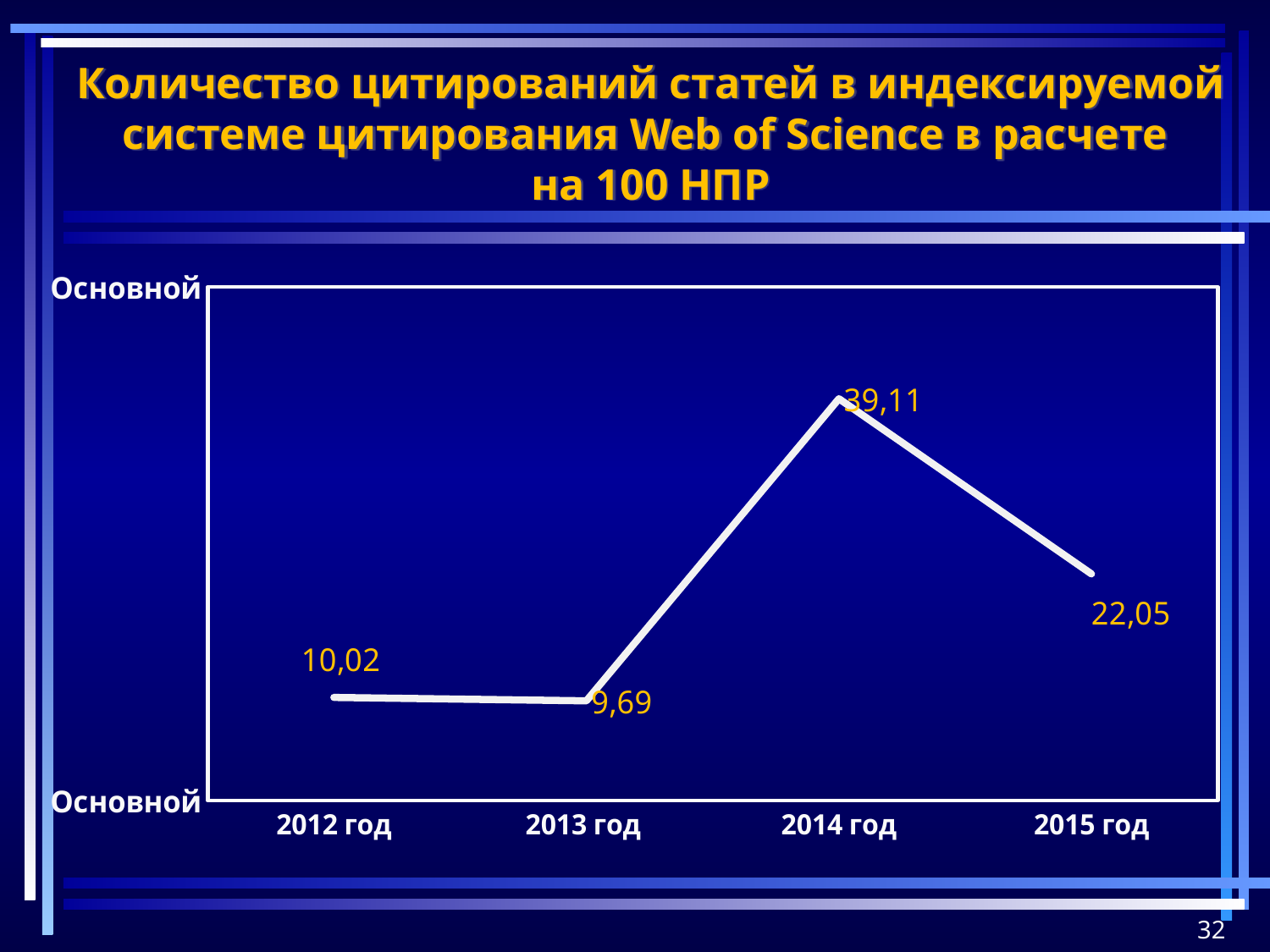
Which is larger, the value for 2015 год or the value for 2012 год? 2015 год What is the value for 2014 год? 39,11 What is the value for 2013 год? 9,69 What is the difference between the values for 2012 год and 2013 год? 0,33 Which year has the highest value? 2014 год What kind of chart is shown on the slide? line chart Which year has the lowest value? 2013 год What is the value for 2015 год? 22,05 How many years are plotted on the chart? 4 What is the value for 2012 год? 10,02 What is the difference between the values for 2014 год and 2015 год? 17,06 Between 2014 год and 2015 год, does the value rise or fall? fall